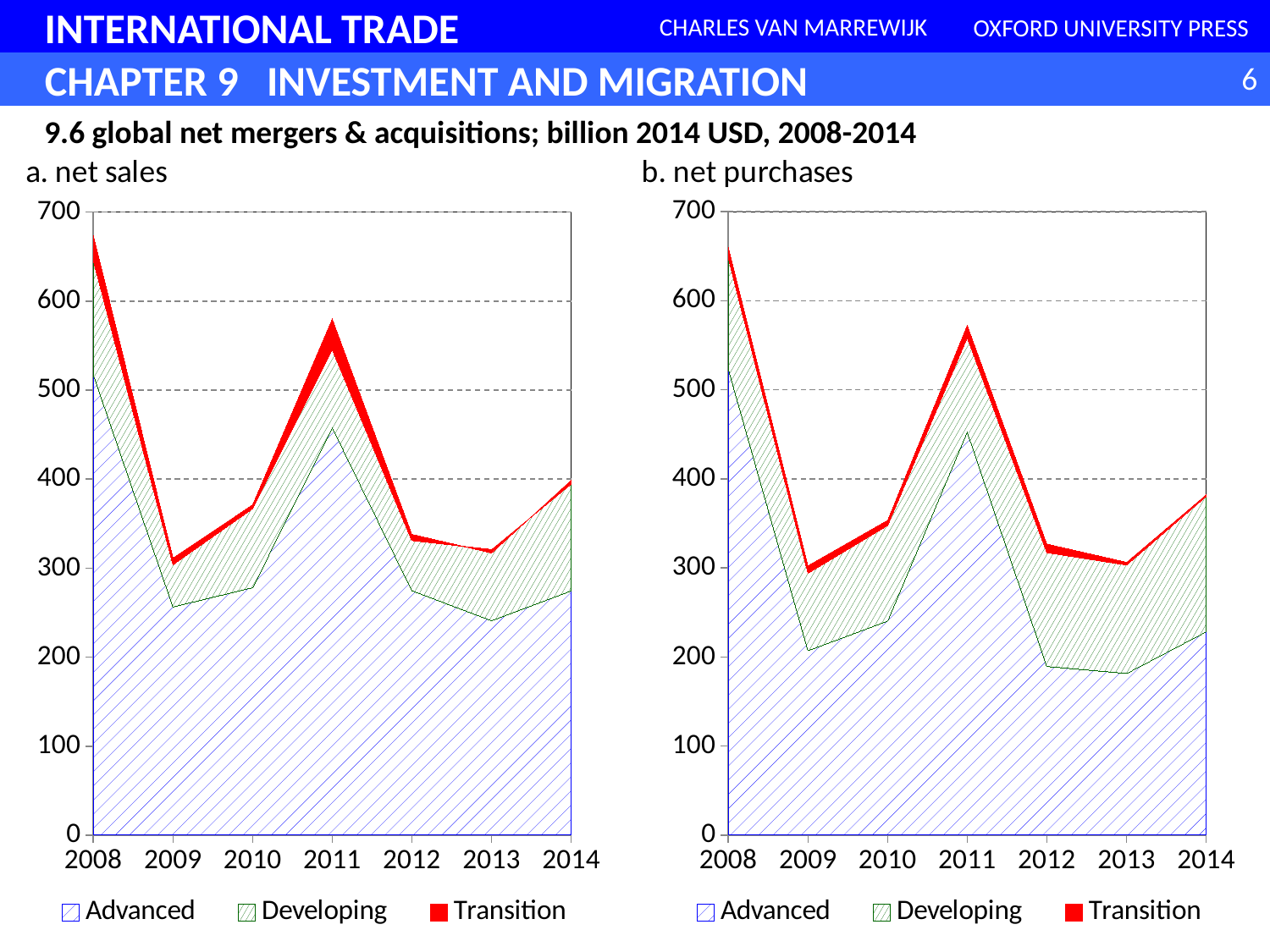
In the 'b. net purchases' chart, which year has the highest total across all three series? 2008 In the 'a. net sales' chart, which year has the highest total across all three series? 2008 In the 'b. net purchases' chart, is the total for 2011 greater or less than 500? greater What kind of chart is the 'a. net sales' chart? stacked area chart In the 'b. net purchases' chart, is the total for 2008 larger or the total for 2011? 2008 In the 'a. net sales' chart, is the total for 2008 greater or less than 600? greater In the 'a. net sales' chart, does the total rise or fall from 2013 to 2014? rise In the 'a. net sales' chart, which year has the lowest value for Advanced? 2013 How many years are plotted on the x axis of the 'b. net purchases' chart? 7 In the 'a. net sales' chart, is the value for Advanced in 2013 greater or less than 300? less How many series does the legend of the 'a. net sales' chart list? 3